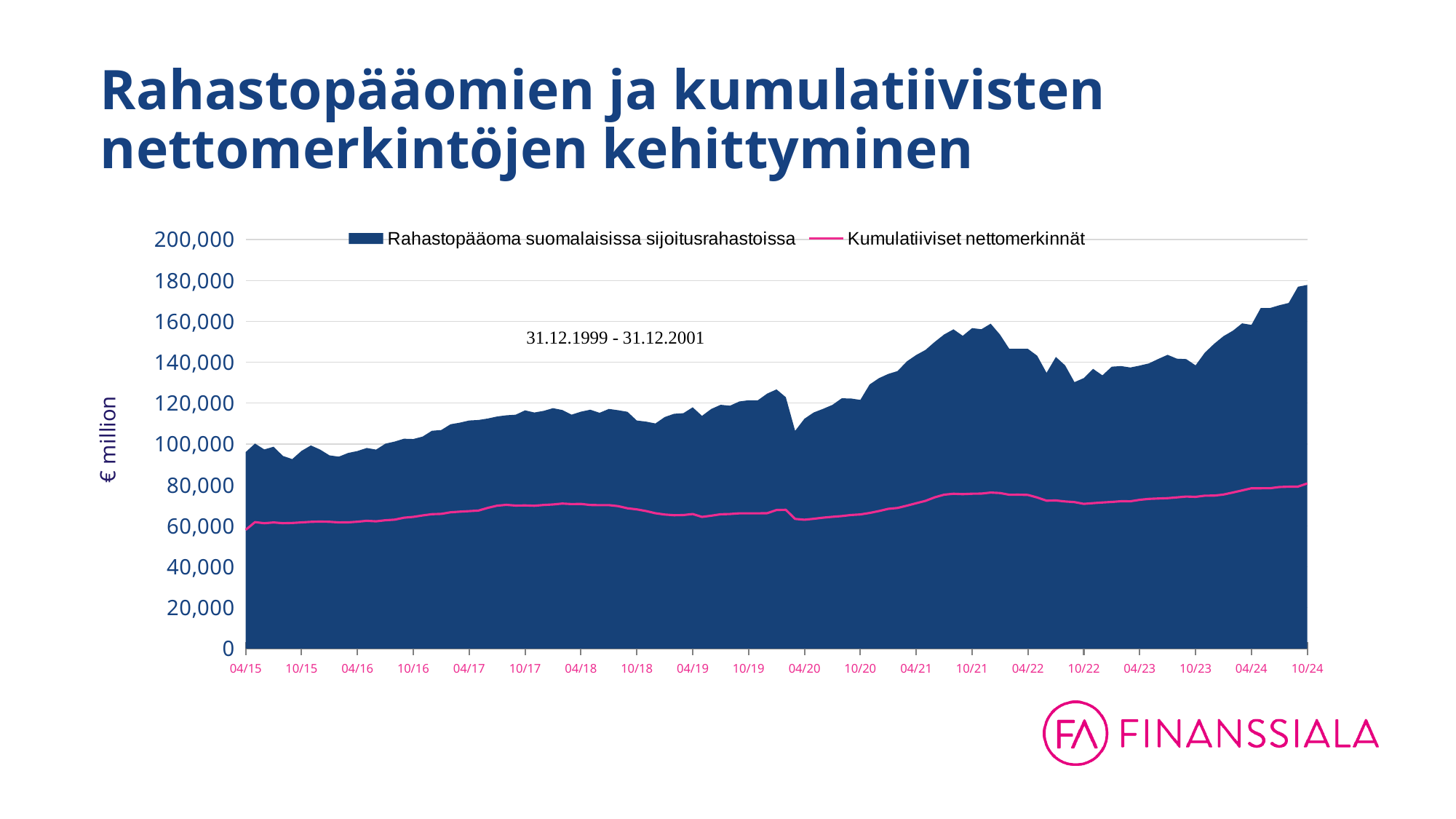
What is the label on the vertical axis? € million Is the value of Kumulatiiviset nettomerkinnät at 10/24 greater or less than 60,000? greater Does Kumulatiiviset nettomerkinnät rise or fall overall from 04/15 to 10/24? rise How many series does the legend list? 2 At 10/24, which series has the higher value: Rahastopääoma suomalaisissa sijoitusrahastoissa or Kumulatiiviset nettomerkinnät? Rahastopääoma suomalaisissa sijoitusrahastoissa What are the two series named in the legend? Rahastopääoma suomalaisissa sijoitusrahastoissa; Kumulatiiviset nettomerkinnät Is the value of Kumulatiiviset nettomerkinnät at 04/15 greater or less than 80,000? less Is the value of Rahastopääoma suomalaisissa sijoitusrahastoissa at 10/24 greater or less than 160,000? greater Does Rahastopääoma suomalaisissa sijoitusrahastoissa rise or fall overall from 04/15 to 10/24? rise What kind of chart is shown on the slide? Area chart with a line At which x-axis label does Rahastopääoma suomalaisissa sijoitusrahastoissa reach its highest value? 10/24